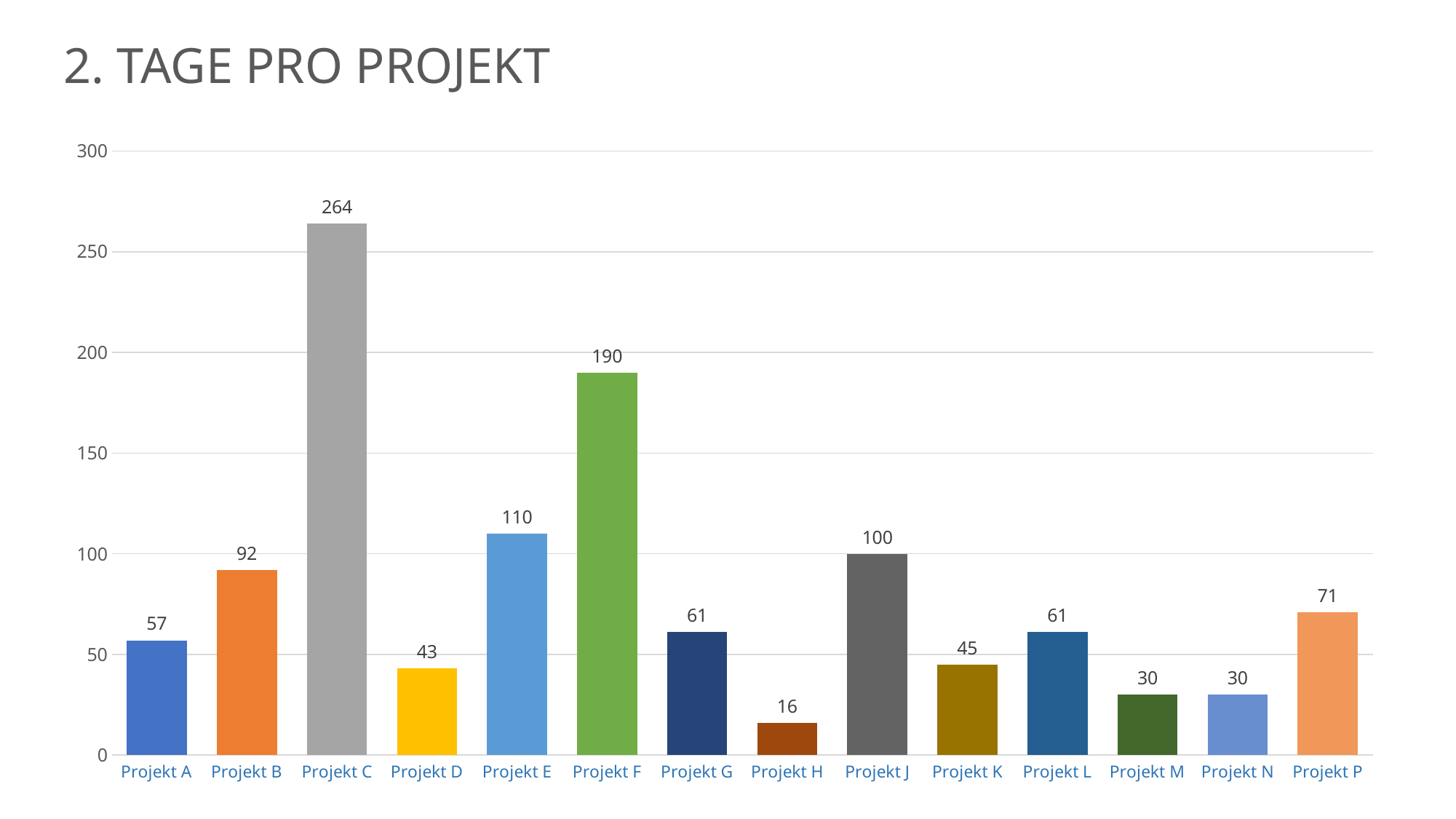
Which is larger, the value for Projekt P or the value for Projekt G? Projekt P What is the title of the slide? 2. TAGE PRO PROJEKT Which project has the highest value? Projekt C What kind of chart is shown on the slide? Bar chart Is the value for Projekt F greater or less than 150? greater What is the difference between the values for Projekt E and Projekt B? 18 What is the value for Projekt H? 16 What is the difference between the values for Projekt C and Projekt F? 74 How many projects are shown on the chart? 14 What is the value for Projekt C? 264 Which project has the lowest value? Projekt H What is the value for Projekt J? 100